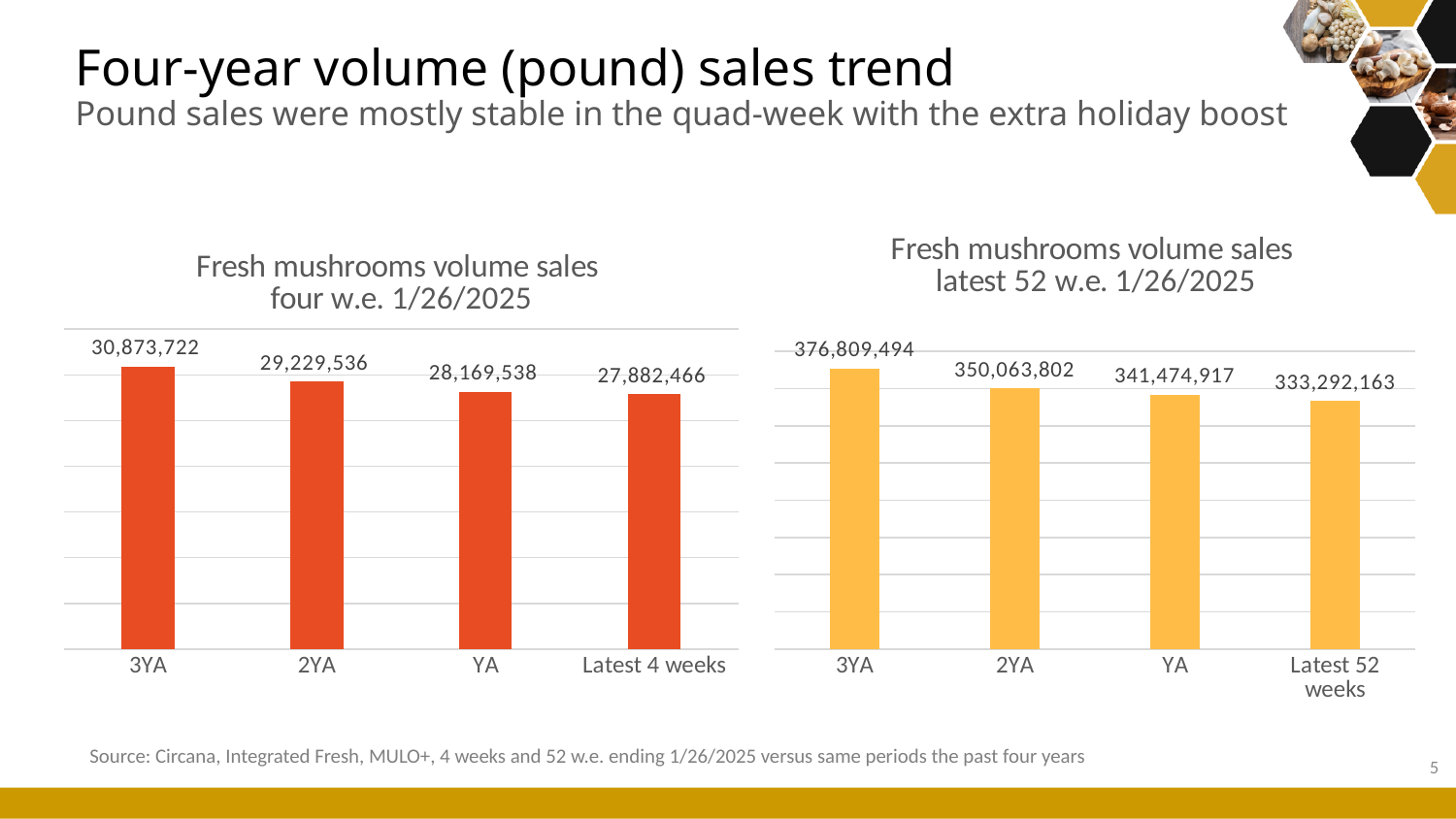
In the 'Fresh mushrooms volume sales four w.e. 1/26/2025' chart, what is the difference between the 3YA value and the Latest 4 weeks value? 2,991,256 How many categories are shown in the 'Fresh mushrooms volume sales latest 52 w.e. 1/26/2025' chart? 4 What kind of chart is the 'Fresh mushrooms volume sales four w.e. 1/26/2025' chart? Bar chart In the 'Fresh mushrooms volume sales four w.e. 1/26/2025' chart, which is larger, the value for 2YA or the value for YA? 2YA In the 'Fresh mushrooms volume sales four w.e. 1/26/2025' chart, what is the value for Latest 4 weeks? 27,882,466 In the 'Fresh mushrooms volume sales latest 52 w.e. 1/26/2025' chart, what is the value for YA? 341,474,917 In the 'Fresh mushrooms volume sales latest 52 w.e. 1/26/2025' chart, do the values rise or fall from 3YA to Latest 52 weeks? Fall In the 'Fresh mushrooms volume sales four w.e. 1/26/2025' chart, what is the value for 3YA? 30,873,722 In the 'Fresh mushrooms volume sales latest 52 w.e. 1/26/2025' chart, what is the value for Latest 52 weeks? 333,292,163 In the 'Fresh mushrooms volume sales four w.e. 1/26/2025' chart, which category has the highest value? 3YA In the 'Fresh mushrooms volume sales latest 52 w.e. 1/26/2025' chart, which category has the lowest value? Latest 52 weeks In the 'Fresh mushrooms volume sales latest 52 w.e. 1/26/2025' chart, what is the difference between the 2YA value and the YA value? 8,588,885